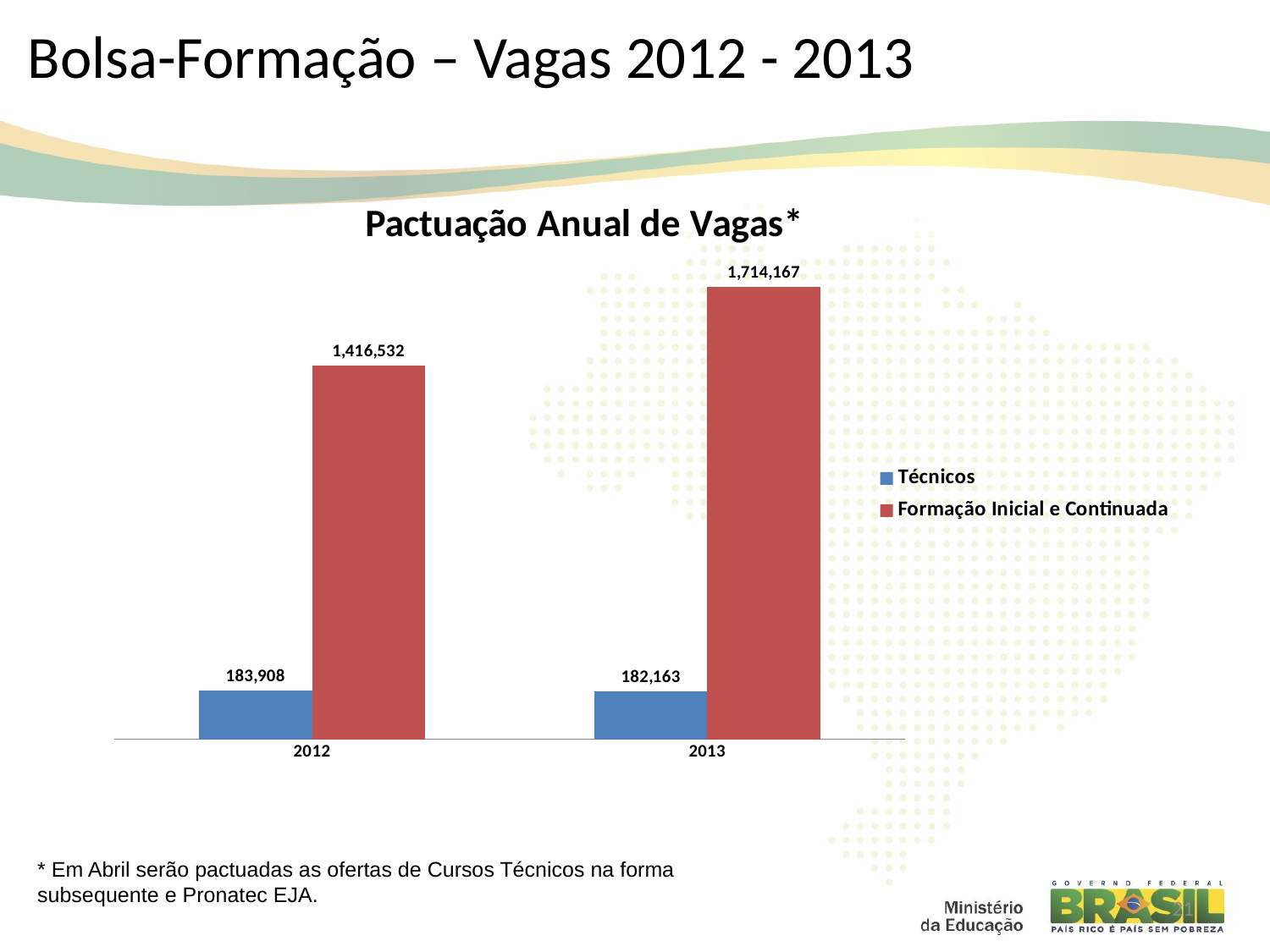
What is the value for Formação Inicial e Continuada in 2012? 1,416,532 What is the value for Formação Inicial e Continuada in 2013? 1,714,167 Which is larger: Formação Inicial e Continuada in 2012 or Técnicos in 2013? Formação Inicial e Continuada in 2012 Which series has the lowest value in 2013? Técnicos What is the value for Técnicos in 2012? 183,908 In which year is the value for Formação Inicial e Continuada highest? 2013 What is the value for Técnicos in 2013? 182,163 What is the difference between the Formação Inicial e Continuada values for 2013 and 2012? 297,635 What kind of chart is shown on the slide? Bar chart How many years are shown on the x axis? 2 What is the difference between the Técnicos values for 2012 and 2013? 1,745 How many series does the legend list? 2